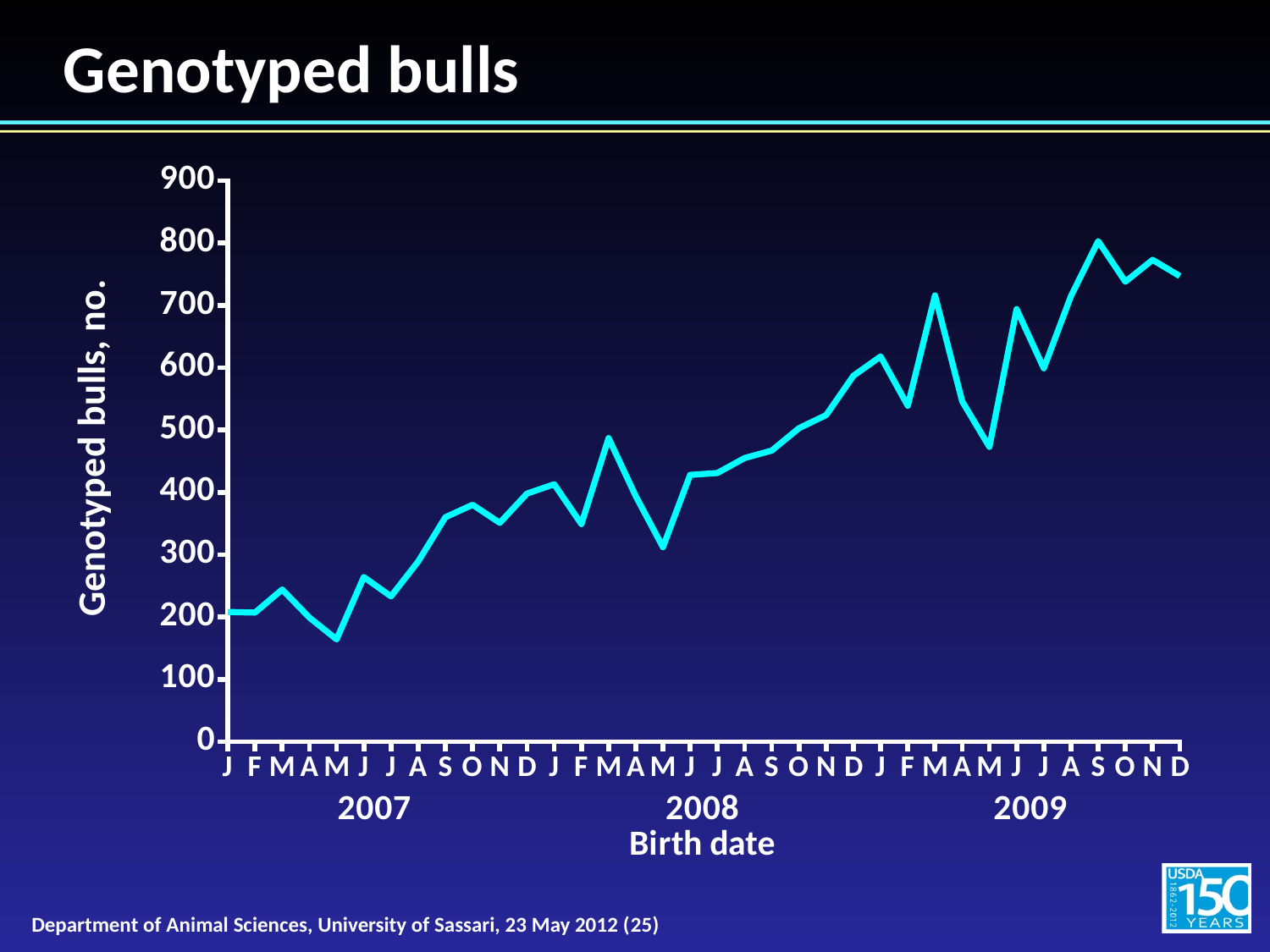
What is the label of the y axis? Genotyped bulls, no. What kind of chart is shown on the slide? line chart Is the value for September 2009 greater or less than 700? greater Overall, do the values rise or fall from January 2007 to December 2009? rise Is the value for May 2008 greater or less than 400? less Which month has the highest number of genotyped bulls? September 2009 How many monthly data points are plotted on the chart? 36 Which is larger, the value for January 2007 or the value for December 2009? December 2009 Is the value for May 2007 greater or less than 200? less What is the title of the chart? Genotyped bulls Which month has the lowest number of genotyped bulls? May 2007